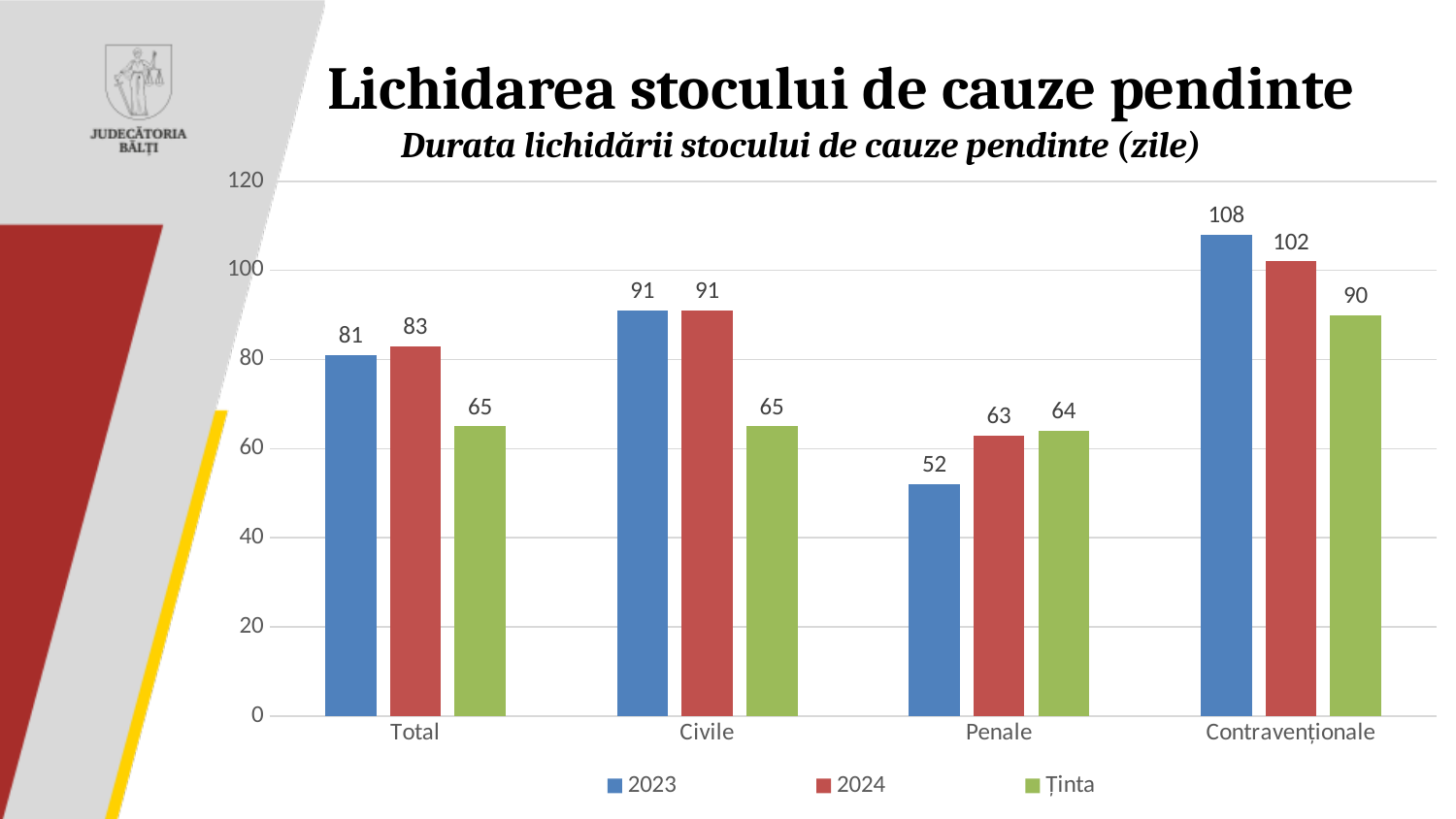
What kind of chart is shown on the slide? Bar chart Which category has the lowest 2024 value? Penale How many series does the legend list? 3 What is the title of the chart? Durata lichidării stocului de cauze pendinte (zile) What is the Ținta value for Contravenționale? 90 Is the 2023 value for Contravenționale greater or less than 100? greater What is the 2023 value for Penale? 52 Which is larger for Total: the 2023 value or the 2024 value? 2024 What is the difference between the 2023 and 2024 values for Contravenționale? 6 Which category has the highest 2023 value? Contravenționale How many categories are shown on the x axis? 4 What is the 2024 value for Civile? 91